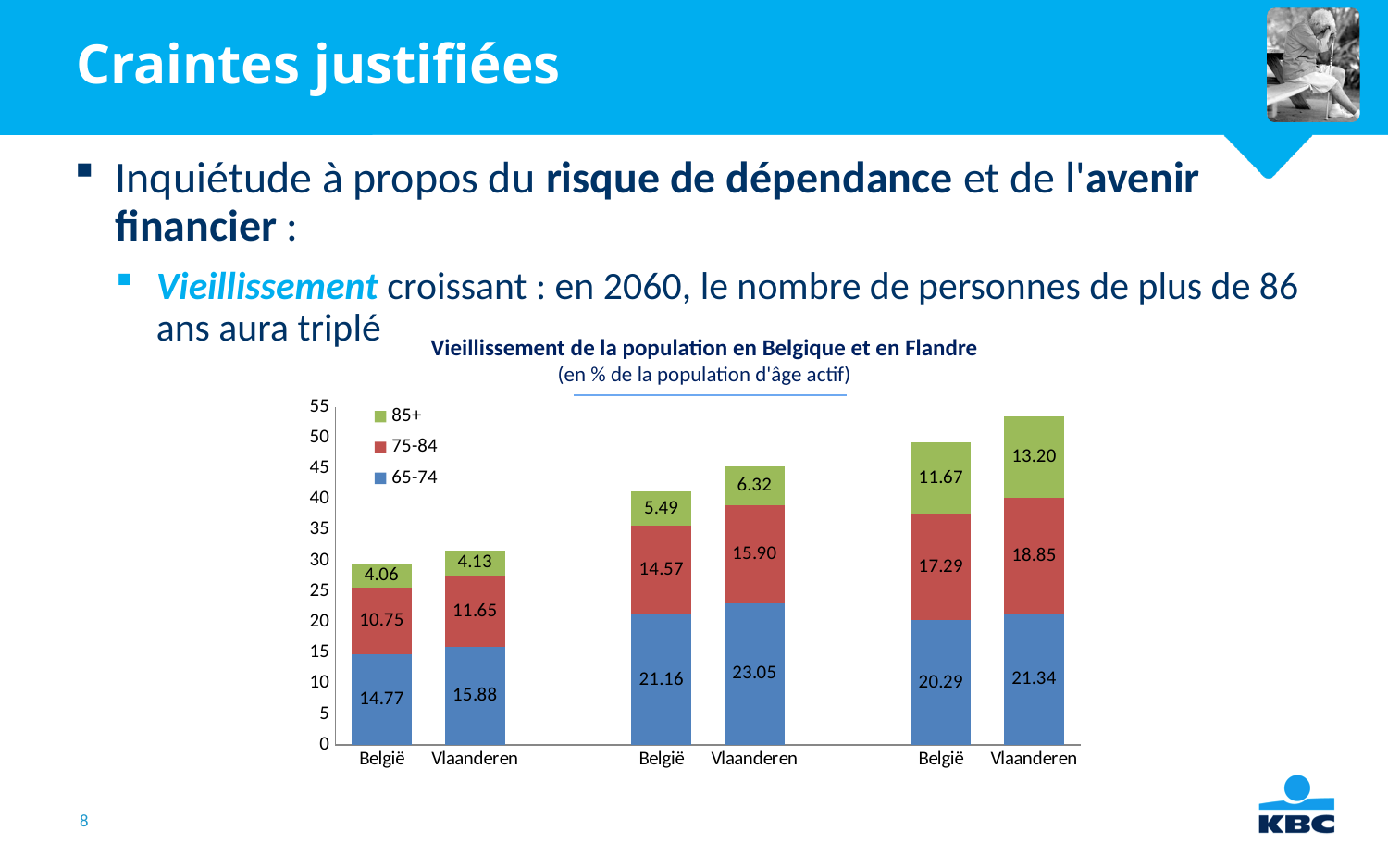
Do the total bar heights rise or fall from the leftmost pair to the rightmost pair? Rise What kind of chart is shown on the slide? Stacked bar chart How many series does the chart legend list? 3 What is the 85+ value for the rightmost Vlaanderen bar? 13.20 Which bar has the highest 85+ value? The rightmost Vlaanderen bar (13.20) What is the 65-74 value for the leftmost België bar? 14.77 In the middle pair of bars, which has the larger 65-74 value, België or Vlaanderen? Vlaanderen (23.05) Which bar has the lowest 65-74 value? The leftmost België bar (14.77) What is the total of the leftmost België stacked bar? 29.58 How many bars are plotted in the chart? 6 What is the 75-84 value for the middle Vlaanderen bar? 15.90 In the rightmost pair of bars, what is the difference between the 75-84 values for Vlaanderen and België? 1.56